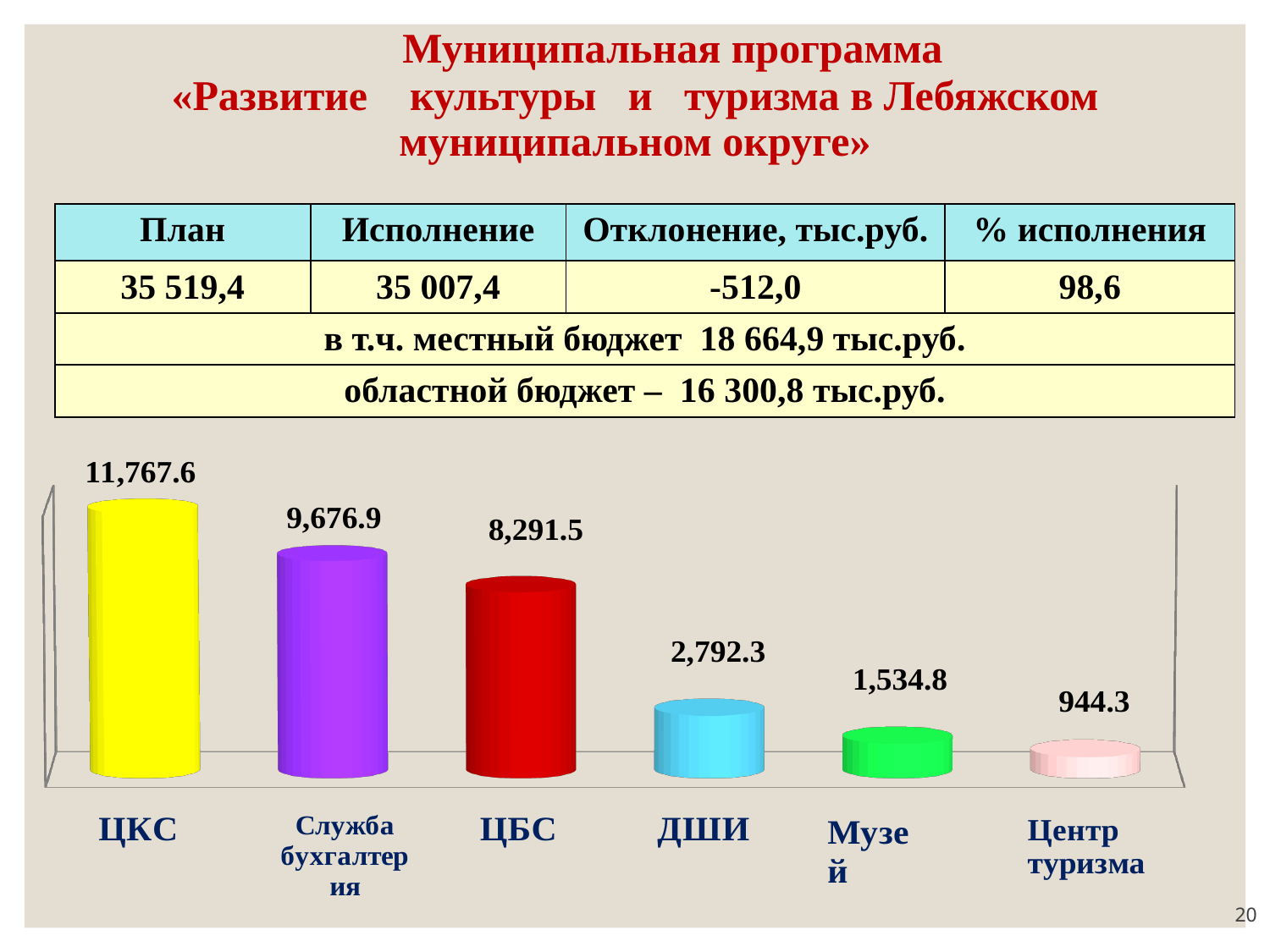
What is the difference between the values for ДШИ and Музей? 1,257.5 Which is larger, the value for ЦБС or the value for ДШИ? ЦБС What is the difference between the values for ЦКС and Служба бухгалтерия? 2,090.7 Do the values rise or fall from left to right across the categories? Fall What kind of chart is shown on the slide? Bar chart Which category has the highest value? ЦКС Which category has the lowest value? Центр туризма What is the value for Музей? 1,534.8 What is the value for ЦКС? 11,767.6 How many categories are shown in the chart? 6 What is the value for ЦБС? 8,291.5 What is the value for Центр туризма? 944.3